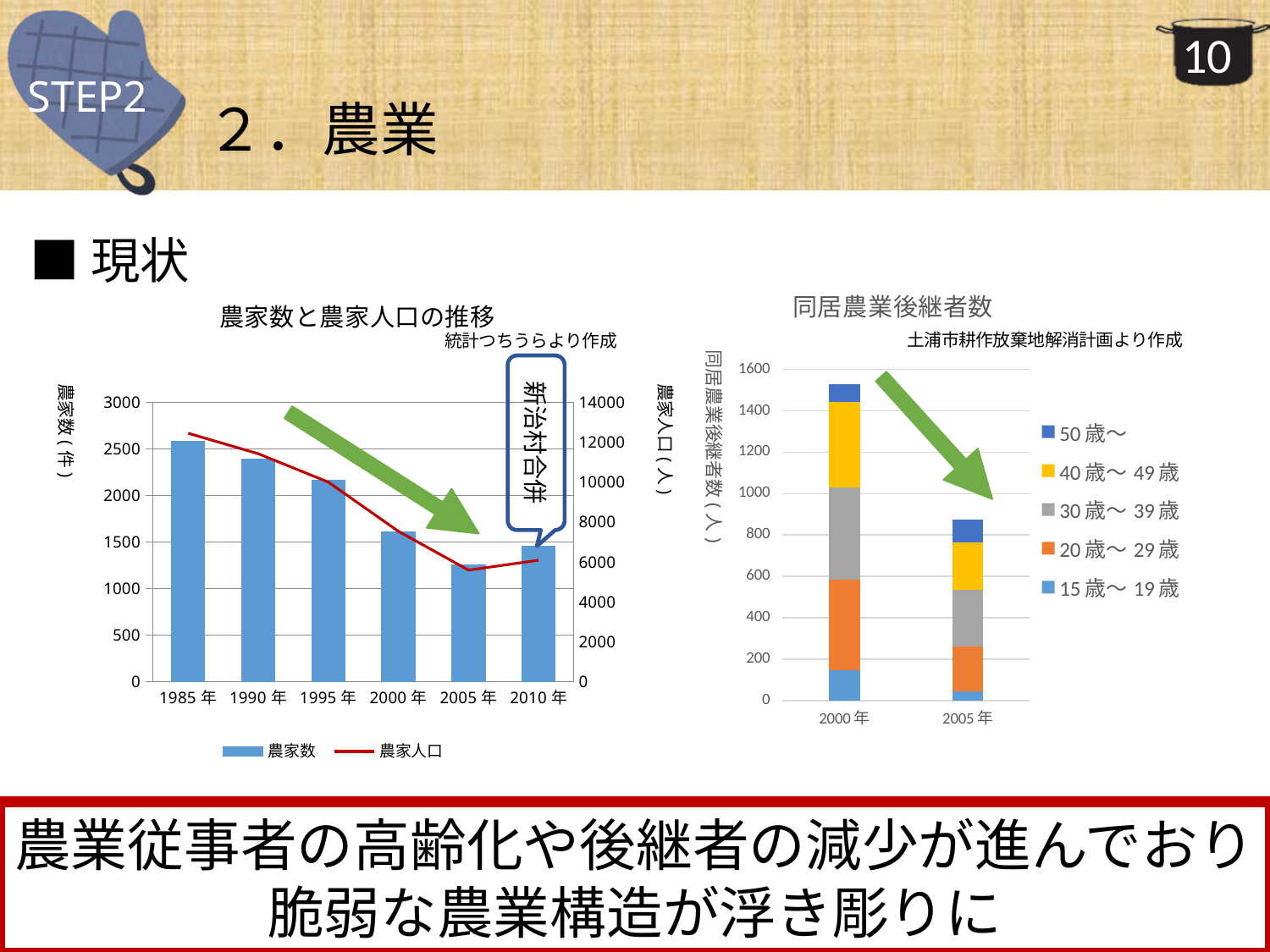
In the left chart 農家数と農家人口の推移, how many series does the legend list? 2 In the left chart 農家数と農家人口の推移, is the 農家数 value for 2005年 greater or less than 1500? less In the left chart 農家数と農家人口の推移, which year has the lowest 農家数 bar? 2005年 What kind of chart is the right chart titled 同居農業後継者数? A stacked bar chart In the left chart 農家数と農家人口の推移, does the 農家数 bar rise or fall from 1985年 to 2005年? Fall In the right chart 同居農業後継者数, which year has the taller stacked bar, 2000年 or 2005年? 2000年 In the right chart 同居農業後継者数, is the total for 2005年 greater or less than 1000? less In the left chart 農家数と農家人口の推移, how many years are shown on the x axis? 6 In the right chart 同居農業後継者数, how many series does the legend list? 5 What kind of chart is the left chart titled 農家数と農家人口の推移? A bar chart combined with a line In the left chart 農家数と農家人口の推移, is the 農家数 value for 1985年 greater or less than 2500? greater In the left chart 農家数と農家人口の推移, which year has the highest 農家数 bar? 1985年